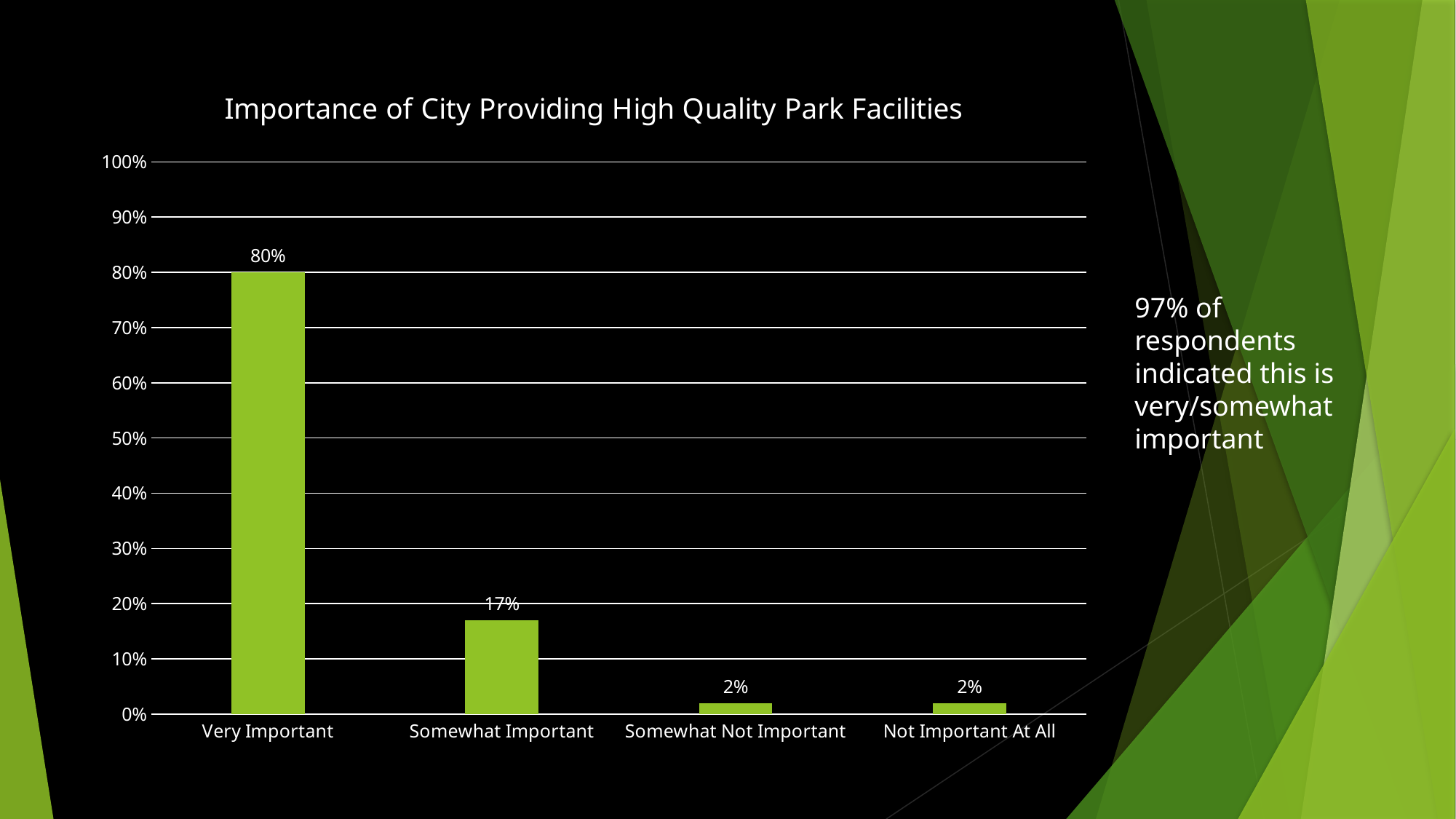
What is the value for Somewhat Not Important? 2% Is the value for Very Important greater or less than 70%? greater What percentage of respondents rated high quality park facilities as Very Important? 80% Which category has the highest value? Very Important What kind of chart is shown on the slide? Bar chart What is the title of the chart? Importance of City Providing High Quality Park Facilities What is the difference between the Very Important and Somewhat Important values? 63% Which is larger, the value for Somewhat Important or the value for Somewhat Not Important? Somewhat Important What is the value for Not Important At All? 2% How many categories are shown on the x axis? 4 What is the value for Somewhat Important? 17% Do the values rise or fall moving from left to right along the x axis? Fall